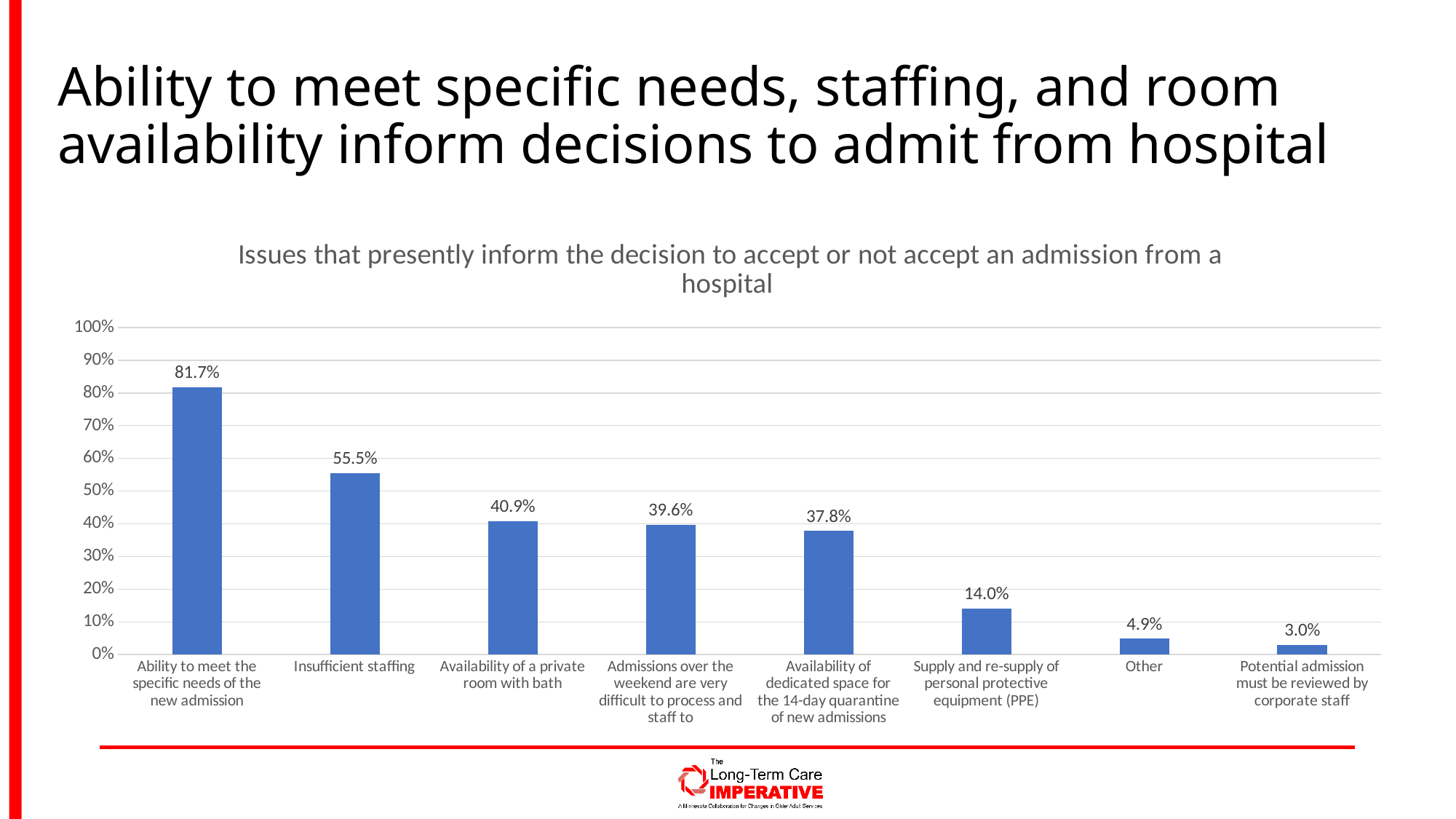
What is the value for "Other"? 4.9% Which category has the lowest value? Potential admission must be reviewed by corporate staff Do the values rise or fall from left to right across the categories? Fall What is the value for "Supply and re-supply of personal protective equipment (PPE)"? 14.0% What is the difference between the values for "Ability to meet the specific needs of the new admission" and "Insufficient staffing"? 26.2% What percentage is shown for "Insufficient staffing"? 55.5% Which category has the highest value? Ability to meet the specific needs of the new admission How many categories are shown in the chart? 8 What is the title of the chart? Issues that presently inform the decision to accept or not accept an admission from a hospital Which is larger: the value for "Availability of a private room with bath" or the value for "Availability of dedicated space for the 14-day quarantine of new admissions"? Availability of a private room with bath What kind of chart is shown on the slide? Bar chart Is the value for "Insufficient staffing" greater or less than 50%? greater